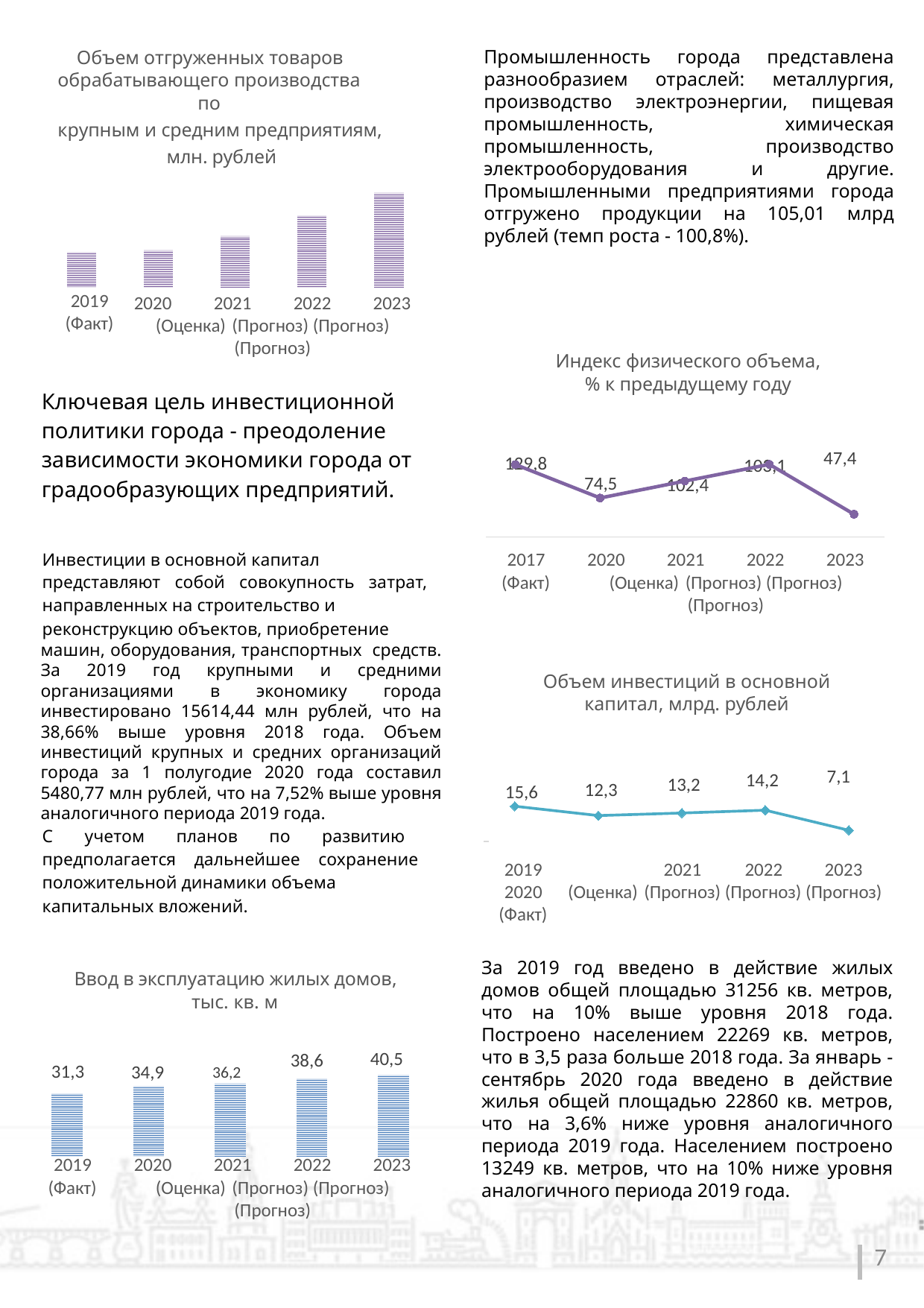
In the chart 'Ввод в эксплуатацию жилых домов, тыс. кв. м', what is the difference between the 2023 and 2019 values? 9,2 In the chart 'Объем инвестиций в основной капитал, млрд. рублей', what is the value for 2021 (Прогноз)? 13,2 In the chart 'Объем отгруженных товаров обрабатывающего производства по крупным и средним предприятиям, млн. рублей', how many bars are shown? 5 In the chart 'Индекс физического объема, % к предыдущему году', which year has the lowest value? 2023 (Прогноз) In the chart 'Ввод в эксплуатацию жилых домов, тыс. кв. м', which year has the lowest value? 2019 (Факт) In the chart 'Индекс физического объема, % к предыдущему году', what is the value for 2020 (Оценка)? 74,5 In the chart 'Объем инвестиций в основной капитал, млрд. рублей', which of 2021 or 2022 has the larger value? 2022 In the chart 'Ввод в эксплуатацию жилых домов, тыс. кв. м', do the values rise or fall from 2019 to 2023? rise In the chart 'Ввод в эксплуатацию жилых домов, тыс. кв. м', what is the value for 2022 (Прогноз)? 38,6 In the chart 'Ввод в эксплуатацию жилых домов, тыс. кв. м', which year has the highest value? 2023 (Прогноз) What kind of chart is 'Объем отгруженных товаров обрабатывающего производства по крупным и средним предприятиям, млн. рублей'? bar chart In the chart 'Объем инвестиций в основной капитал, млрд. рублей', what is the value for 2023 (Прогноз)? 7,1